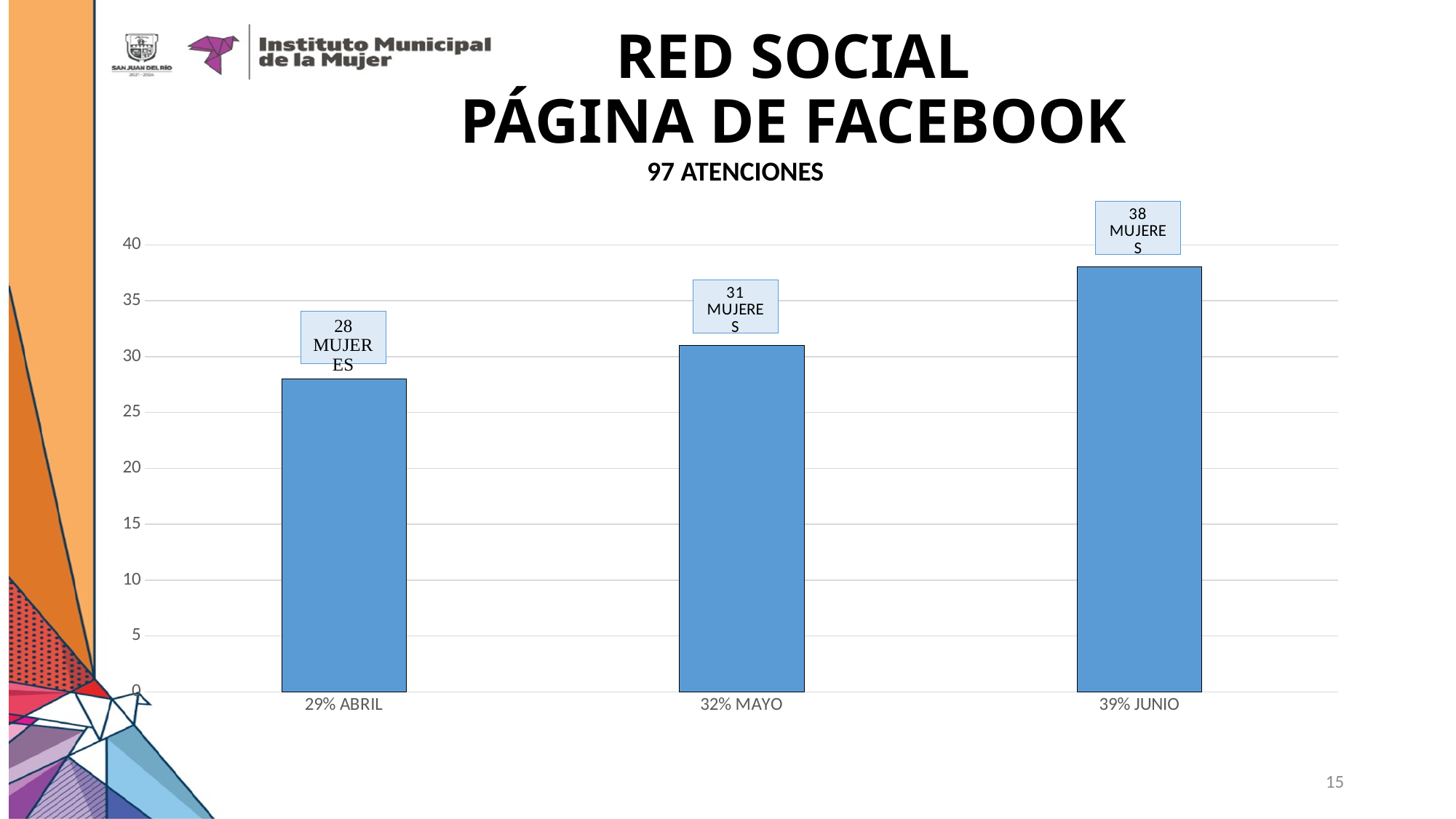
What is the difference between the values for 32% MAYO and 29% ABRIL? 3 What value is shown for 29% ABRIL? 28 MUJERES What value is shown for 39% JUNIO? 38 MUJERES Is the value for 39% JUNIO greater or less than 35? greater How many categories are shown on the x axis? 3 Which category has the lowest value? 29% ABRIL Which is larger, the value for 32% MAYO or the value for 39% JUNIO? 39% JUNIO Do the values rise or fall from ABRIL to JUNIO? rise What value is shown for 32% MAYO? 31 MUJERES What is the difference between the values for 39% JUNIO and 29% ABRIL? 10 What kind of chart is shown on the slide? bar chart Which category has the highest value? 39% JUNIO